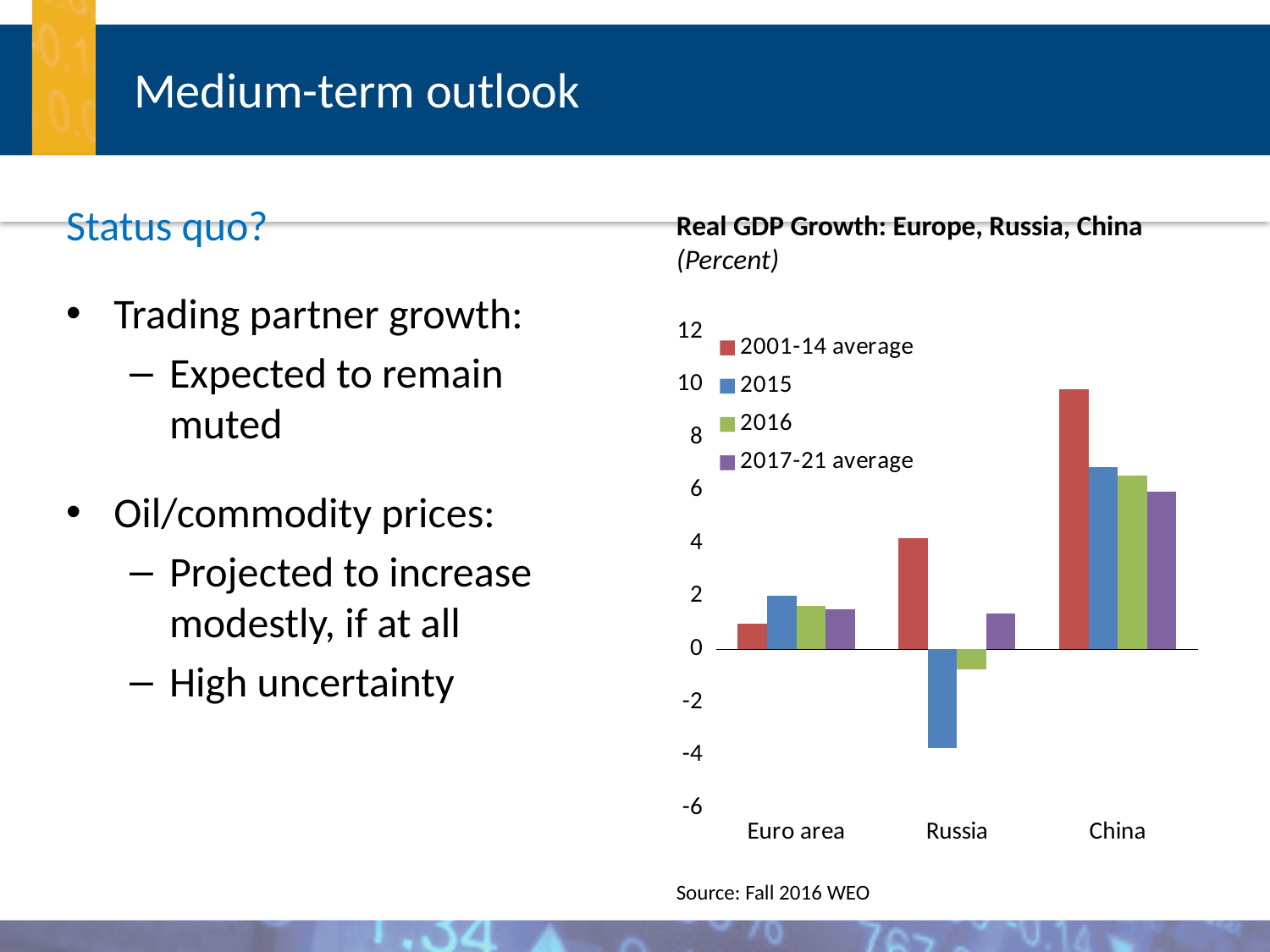
Is the 2015 value for Russia greater or less than -2? less Which category has the lowest bar in the chart? Russia How many categories are shown on the x axis of the chart? 3 Which category has the highest bar in the chart? China How many series does the chart's legend list? 4 What kind of chart is shown on the slide? bar chart Is the 2001-14 average value for Russia greater or less than 2? greater Which is larger, the 2001-14 average for Russia or the 2001-14 average for the Euro area? Russia Is the 2001-14 average value for China greater or less than 8? greater Which is larger, the 2015 value for China or the 2015 value for the Euro area? China What is the title of the chart? Real GDP Growth: Europe, Russia, China What source is cited below the chart? Fall 2016 WEO